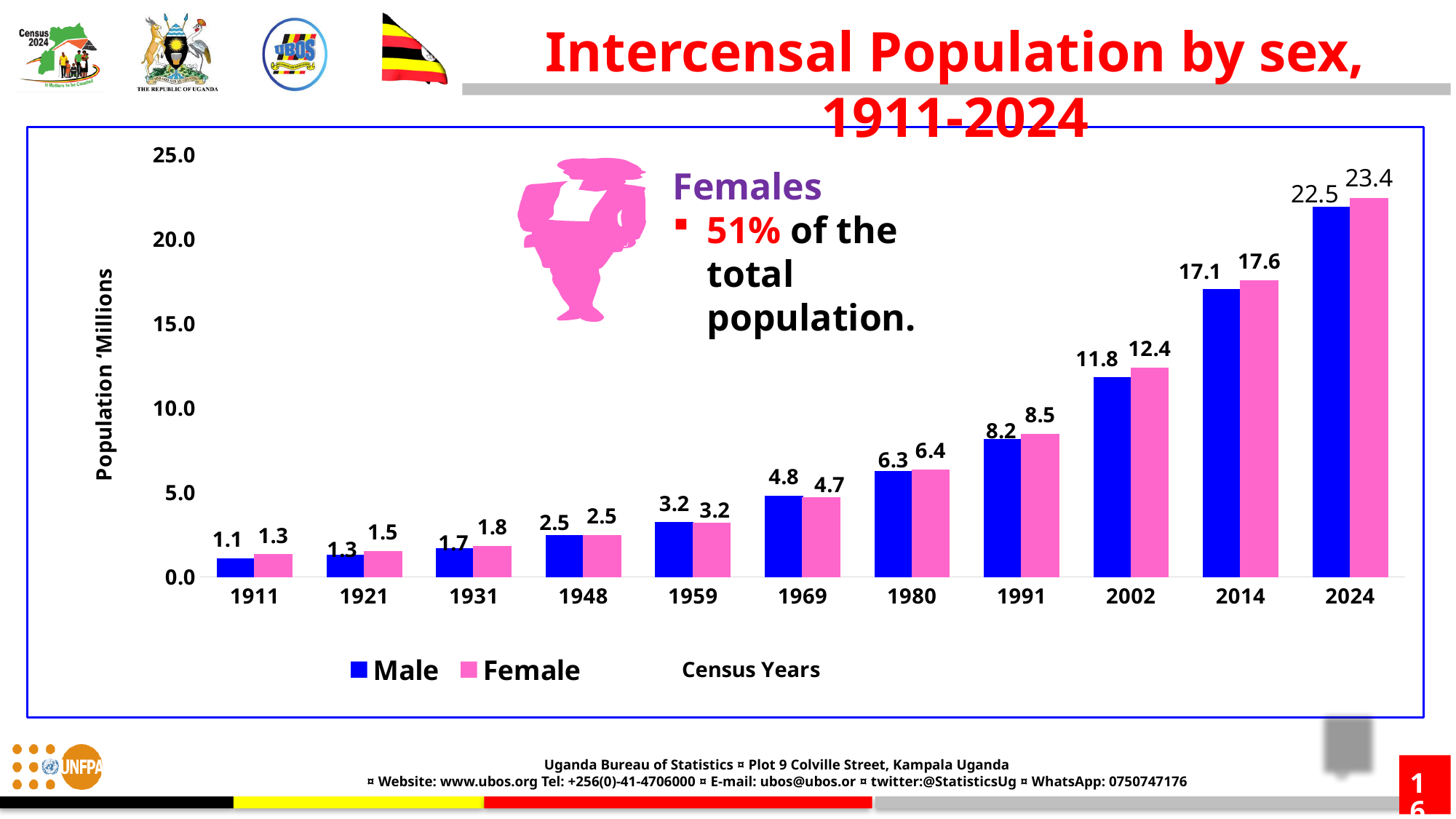
Which census year has the highest male population? 2024 Which census year has the lowest female population? 1911 What is the difference between the female and male population in 2002? 0.6 What is the female population in 2024? 23.4 Is the female population in 2014 greater or less than 15.0? greater What is the male population in 2014? 17.1 What kind of chart is shown on the slide? Bar chart What is the female population in 1991? 8.5 Does the male population rise or fall from 1911 to 2024? Rise In 1969, which is larger, the male or the female population? Male How many census years are shown on the x axis? 11 How many series does the legend list? 2